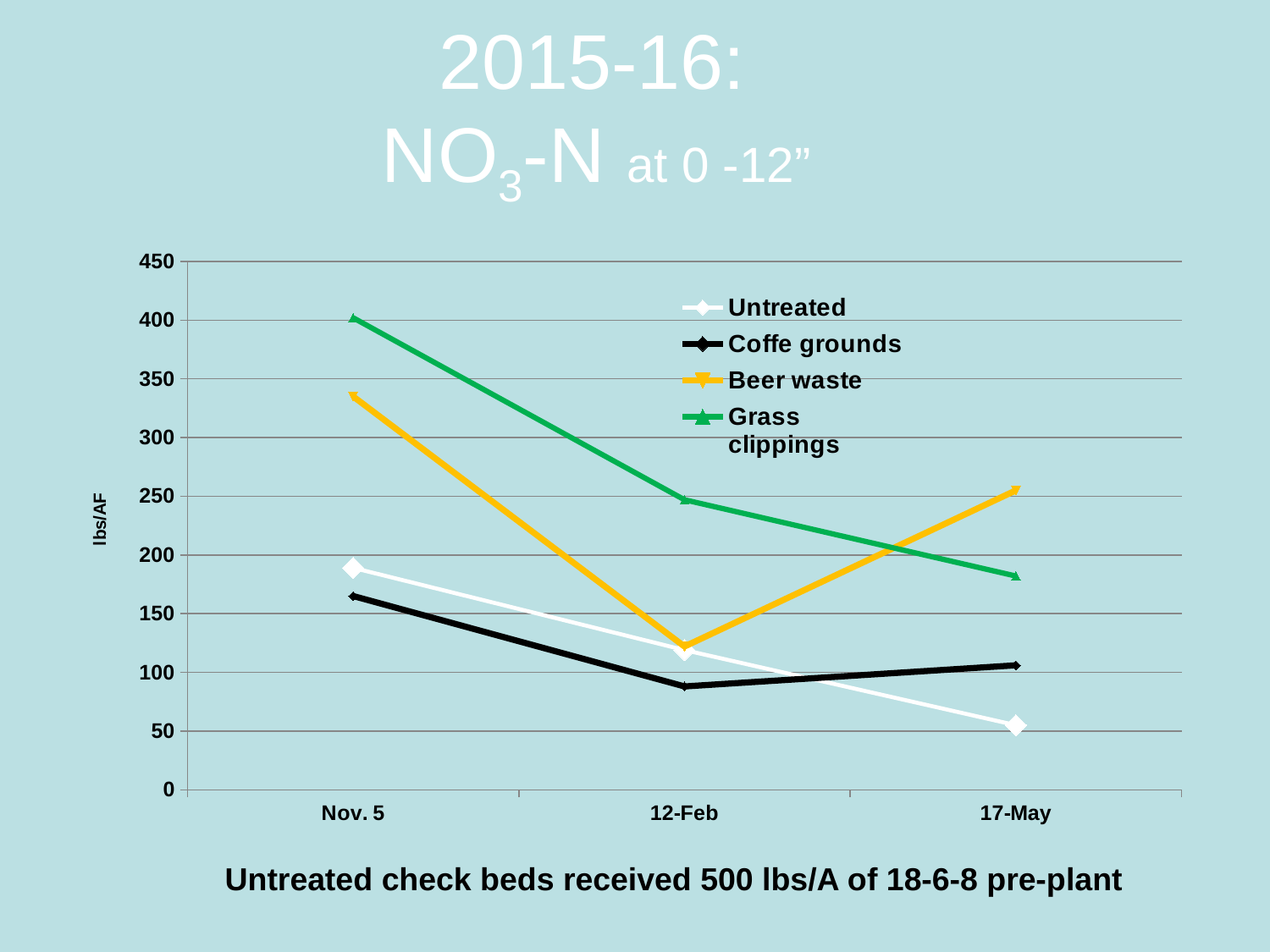
On 17-May, which is larger: Beer waste or Grass clippings? Beer waste What is the label on the y axis? lbs/AF Is the value for Beer waste on 12-Feb greater or less than 150? less Does the Untreated series rise or fall from Nov. 5 to 17-May? fall Is the value for Grass clippings on Nov. 5 greater or less than 350? greater Which series has the highest value on Nov. 5? Grass clippings How many dates are shown along the x axis? 3 What kind of chart is shown on the slide? line chart Is the value for Untreated on 17-May greater or less than 100? less How many series does the legend list? 4 Which series has the highest value on 17-May? Beer waste Which series has the lowest value on 17-May? Untreated